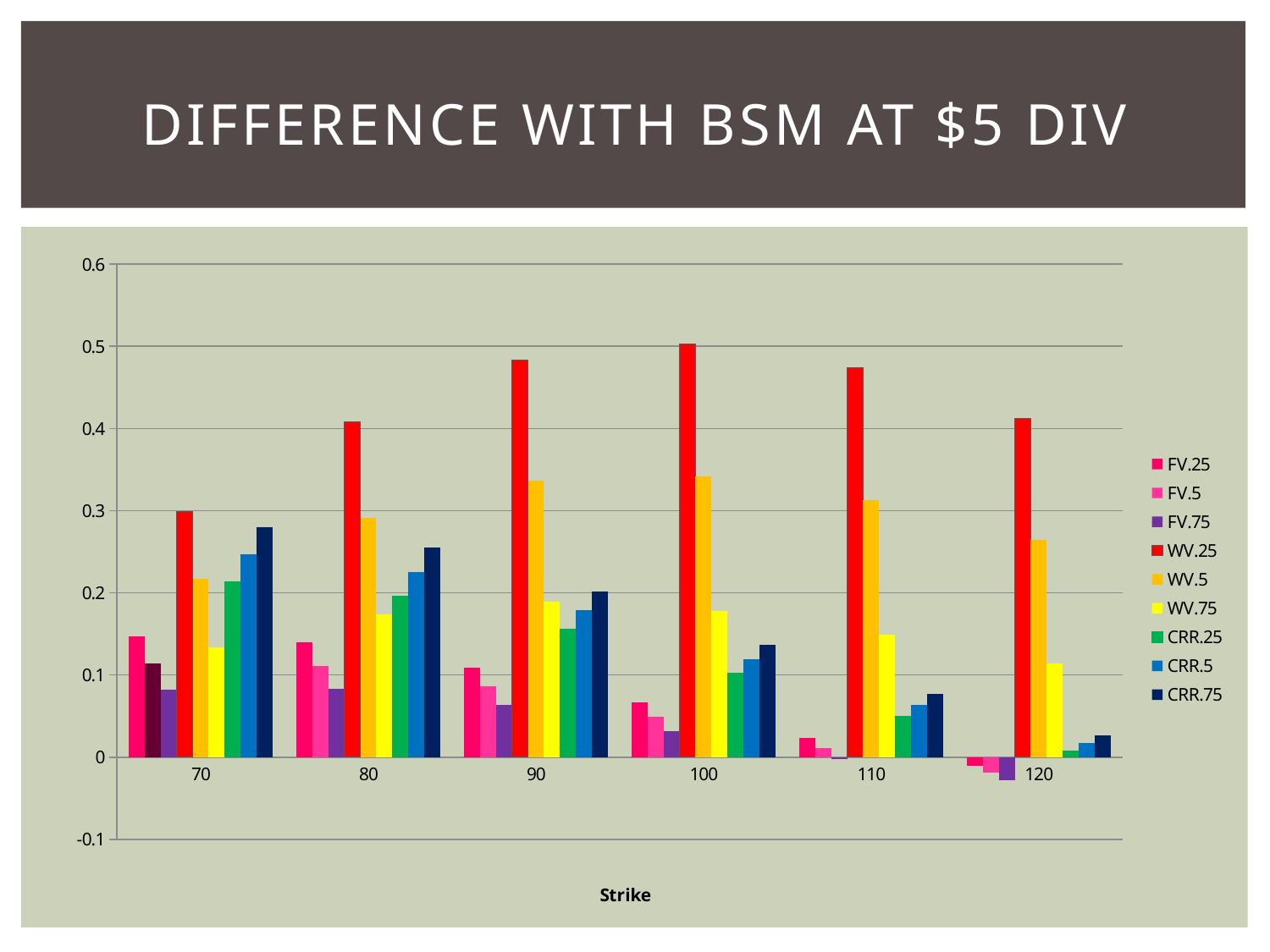
Which series is drawn in red? WV.25 Do the FV.25 values rise or fall as the strike increases from 70 to 120? fall At which strike is the WV.25 bar the highest? 100 How many strike categories are shown on the x axis? 6 What is the title of the x axis? Strike At which strike is the WV.25 bar the lowest? 70 Is the value for WV.5 at strike 70 greater or less than 0.3? less At strike 70, which is larger: the CRR.75 bar or the FV.25 bar? CRR.75 Is the value for CRR.25 at strike 110 greater or less than 0.1? less Is the value for WV.25 at strike 90 greater or less than 0.4? greater What kind of chart is shown on the slide? bar chart How many series does the legend list? 9